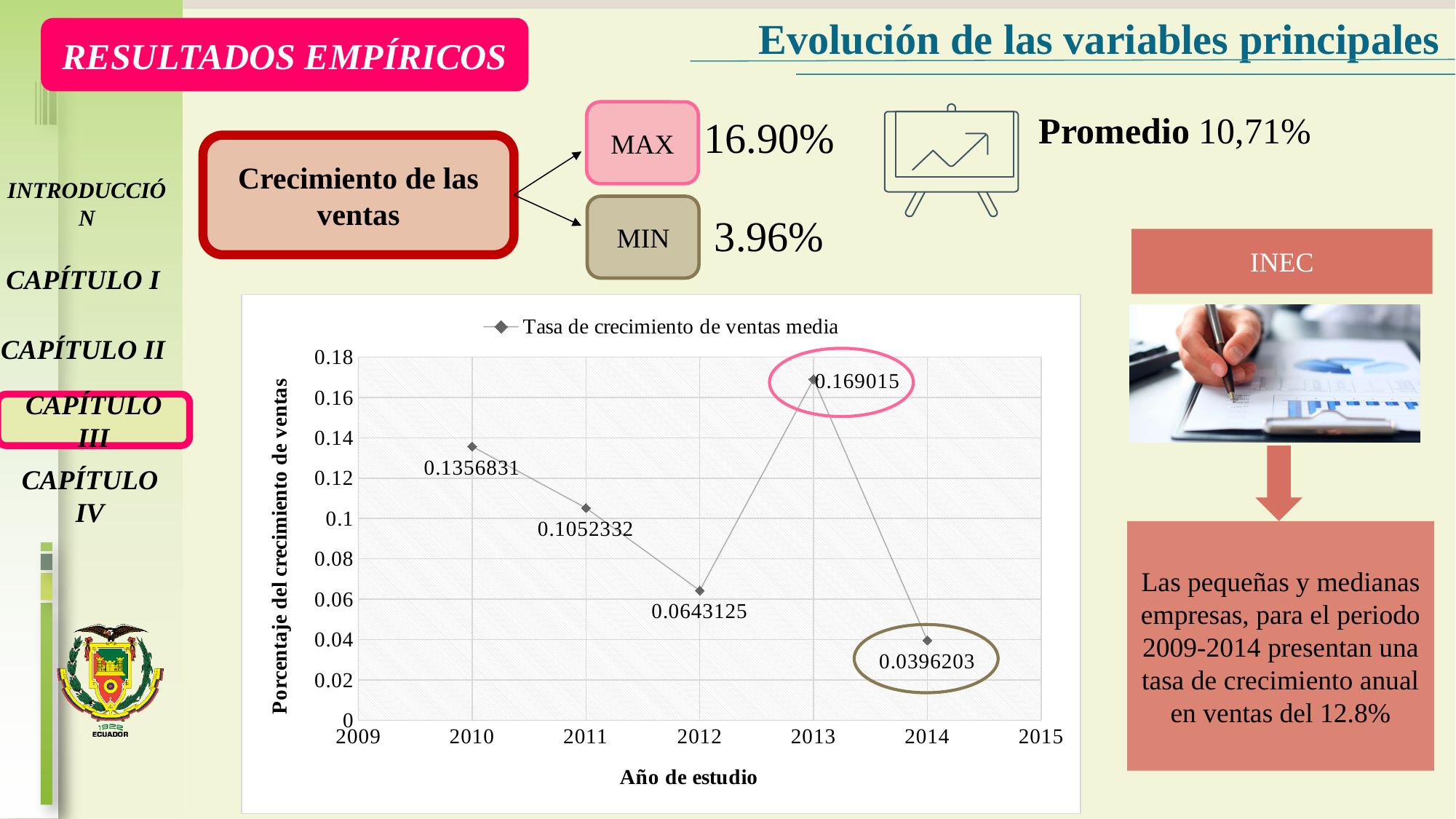
Is the value for 2013 greater or less than 0.16? greater What kind of chart is shown on the slide? line chart What is the difference between the values for 2010 and 2011? 0.0304499 Which is larger, the value for 2011 or the value for 2012? 2011 What is the value plotted for 2010? 0.1356831 Which year has the lowest value on the chart? 2014 What is the difference between the values for 2013 and 2014? 0.1293947 Do the values rise or fall from 2010 to 2012? fall What is the value plotted for 2012? 0.0643125 What is the value plotted for 2013? 0.169015 How many data points are plotted on the chart? 5 Which year has the highest value on the chart? 2013